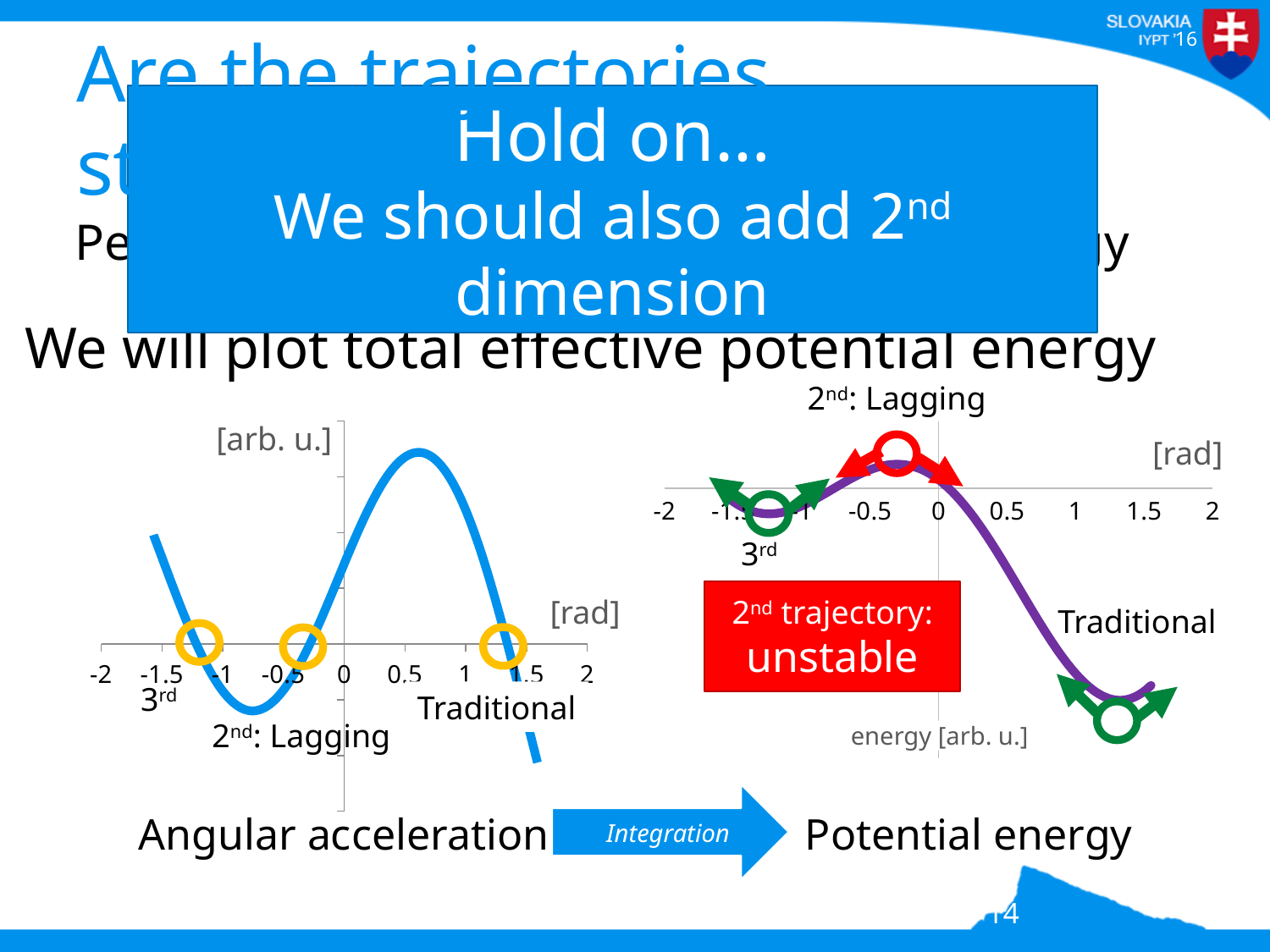
On the Potential energy chart, which trajectory is labelled as unstable? 2nd trajectory On the Potential energy chart, how many tick labels are shown on the x axis? 9 On the Angular acceleration chart, is the value at -0.5 rad greater or less than 0? less On the Angular acceleration chart, is the value at 0.5 rad greater or less than 0? greater What kind of chart is the Angular acceleration chart on the left? line chart On the Angular acceleration chart, does the curve rise or fall between -1 rad and 0.5 rad? rise On the Potential energy chart, at which labelled trajectory is the potential energy highest? 2nd: Lagging On the Potential energy chart, is the energy at -0.5 rad higher or lower than at 1.5 rad? higher On the Angular acceleration chart, what unit is shown on the x axis? [rad] On the Potential energy chart, does the curve rise or fall between 0 rad and 1.5 rad? fall On the Angular acceleration chart, how many points are marked with yellow circles? 3 What kind of chart is the Potential energy chart on the right? line chart